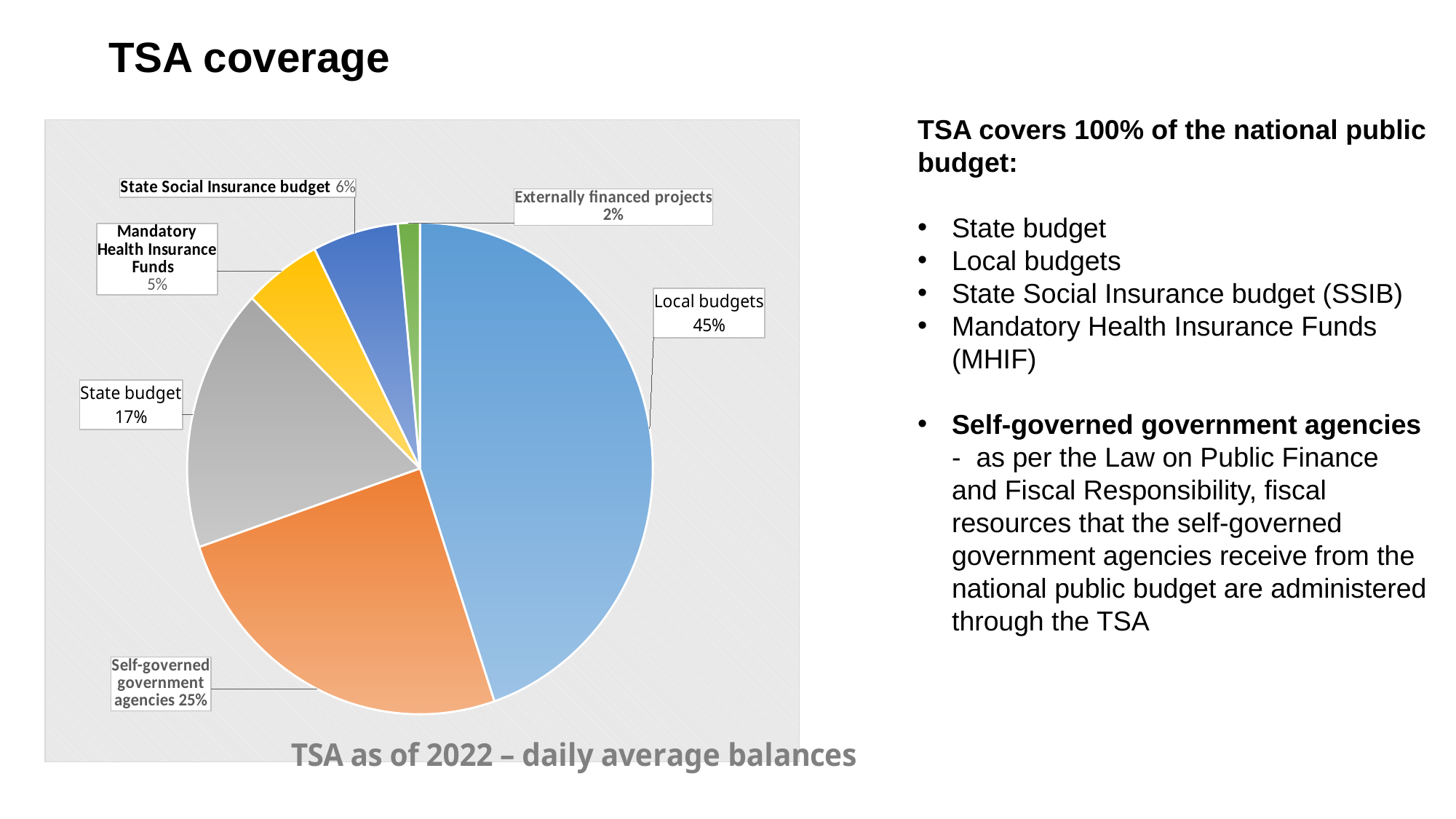
Which category has the smallest slice of the pie? Externally financed projects What kind of chart is shown on the slide? pie chart What share of the pie is State Social Insurance budget? 6% What share of the pie is Self-governed government agencies? 25% What share of the pie is Local budgets? 45% Which is larger, Self-governed government agencies or State budget? Self-governed government agencies What is the difference in percentage points between Local budgets and State budget? 28 How many slices does the pie chart have? 6 Which category has the largest slice of the pie? Local budgets